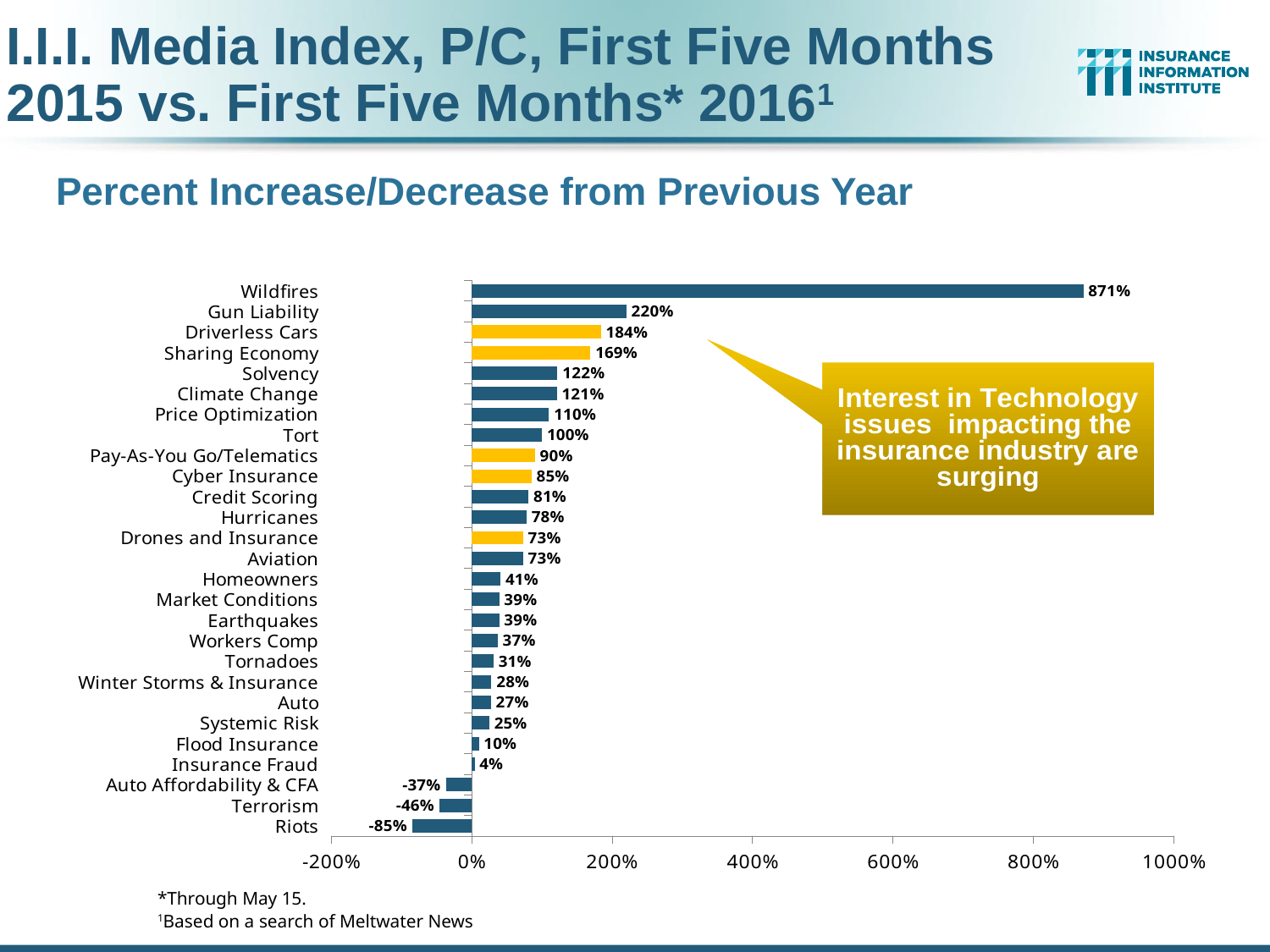
Which has a larger value, Solvency or Tort? Solvency What is the percent change shown for Wildfires? 871% Which category has the lowest percent change? Riots What is the difference between the values for Gun Liability and Driverless Cars? 36% Is the value for Sharing Economy greater or less than 200%? less How many categories show a negative percent change? 3 What kind of chart is shown on the slide? Bar chart What is the percent change shown for Terrorism? -46% How many categories are shown in the chart? 27 What does the callout box on the chart say? Interest in Technology issues impacting the insurance industry are surging Which category has the highest percent increase? Wildfires What is the percent change shown for Cyber Insurance? 85%